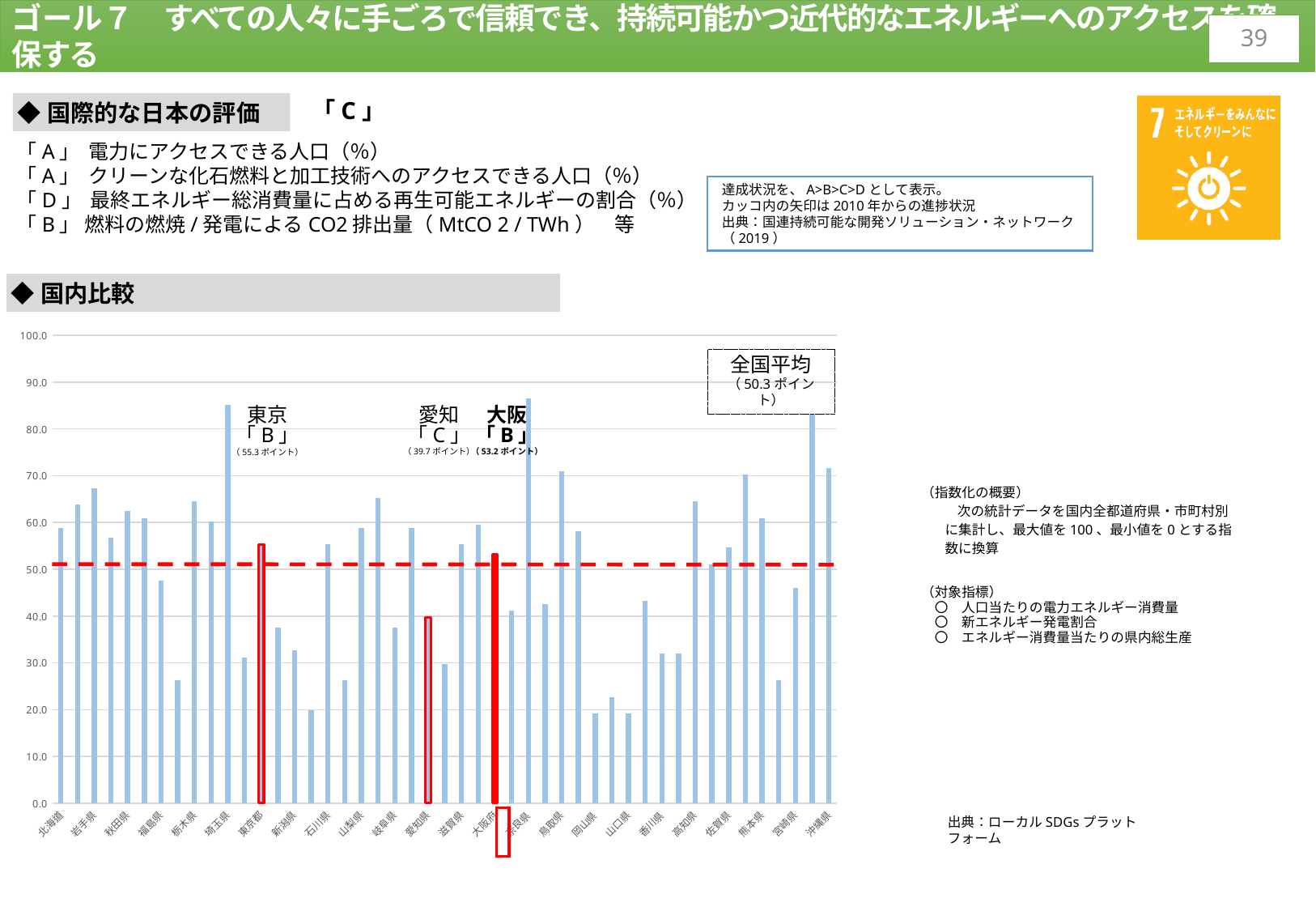
In the 国内比較 chart, which has the higher value, 東京 or 大阪? 東京 In the 国内比較 chart, what is the difference between the values for 東京 and 愛知? 15.6 ポイント What is the 全国平均 value indicated in the 国内比較 chart? 50.3 ポイント What kind of chart is used in the 国内比較 section? bar chart What is the value shown for 東京 in the 国内比較 chart? 55.3 ポイント What does the red dashed horizontal line in the 国内比較 chart represent? 全国平均 (50.3 ポイント) In the 国内比較 chart, is the value for 岡山県 greater or less than 30? less In the 国内比較 chart, which is larger, the value for 愛知 or the 全国平均? 全国平均 In the 国内比較 chart, how much higher is 大阪 than the 全国平均? 2.9 ポイント What is the value shown for 大阪 in the 国内比較 chart? 53.2 ポイント In the 国内比較 chart, is the value for 北海道 greater or less than 50? greater What is the value shown for 愛知 in the 国内比較 chart? 39.7 ポイント